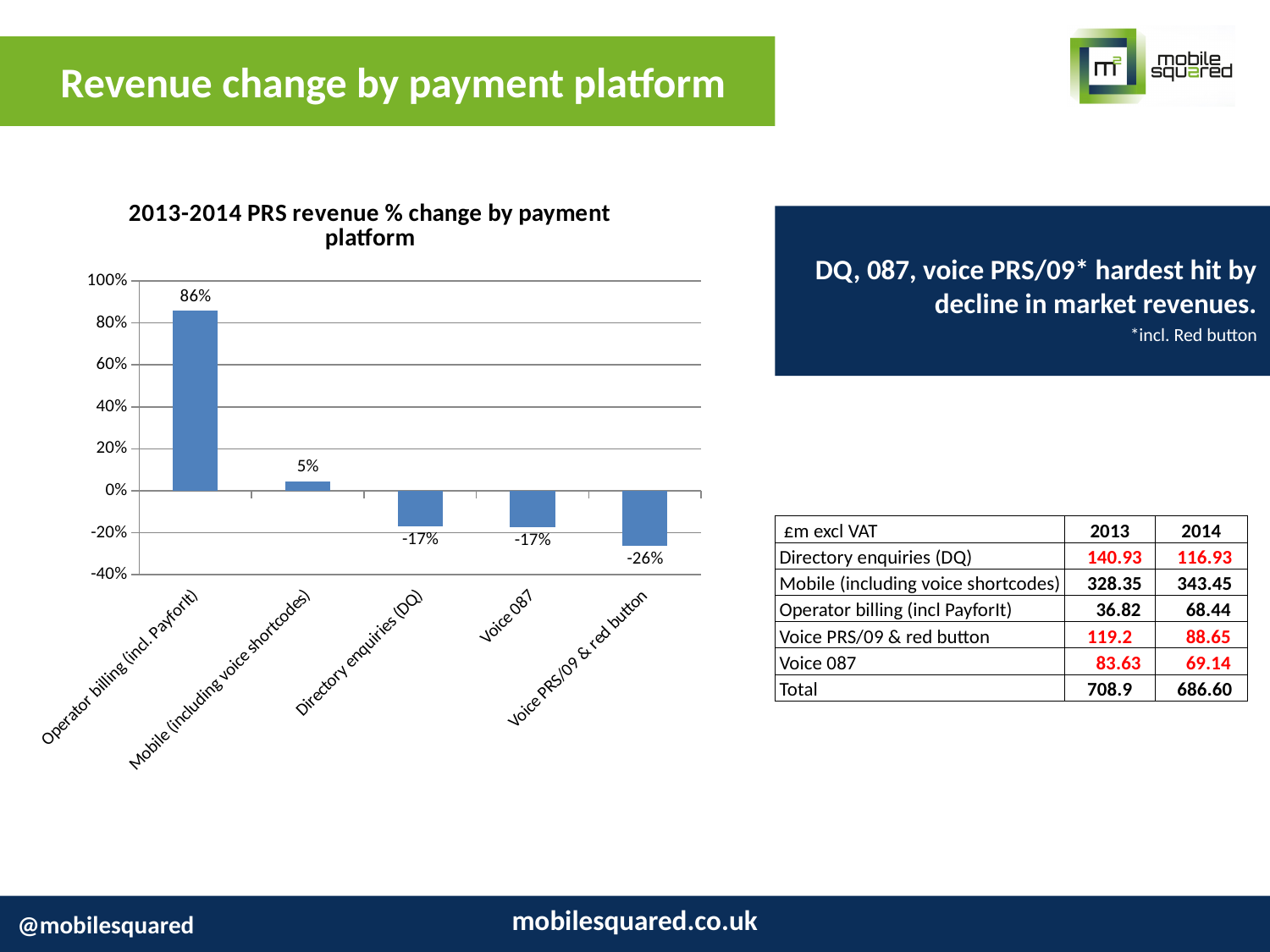
What is the difference between the values for Operator billing (incl. PayforIt) and Mobile (including voice shortcodes)? 81 percentage points What is the title of the chart? 2013-2014 PRS revenue % change by payment platform What is the value for Mobile (including voice shortcodes)? 5% How many payment platforms are shown on the chart? 5 What is the value for Operator billing (incl. PayforIt)? 86% What is the value for Directory enquiries (DQ)? -17% Is the value for Operator billing (incl. PayforIt) greater or less than 80%? greater What kind of chart is shown on the slide? Bar chart Which payment platform has the lowest revenue % change? Voice PRS/09 & red button Which is larger, the value for Mobile (including voice shortcodes) or the value for Voice 087? Mobile (including voice shortcodes) Which payment platform has the highest revenue % change? Operator billing (incl. PayforIt) What is the value for Voice PRS/09 & red button? -26%